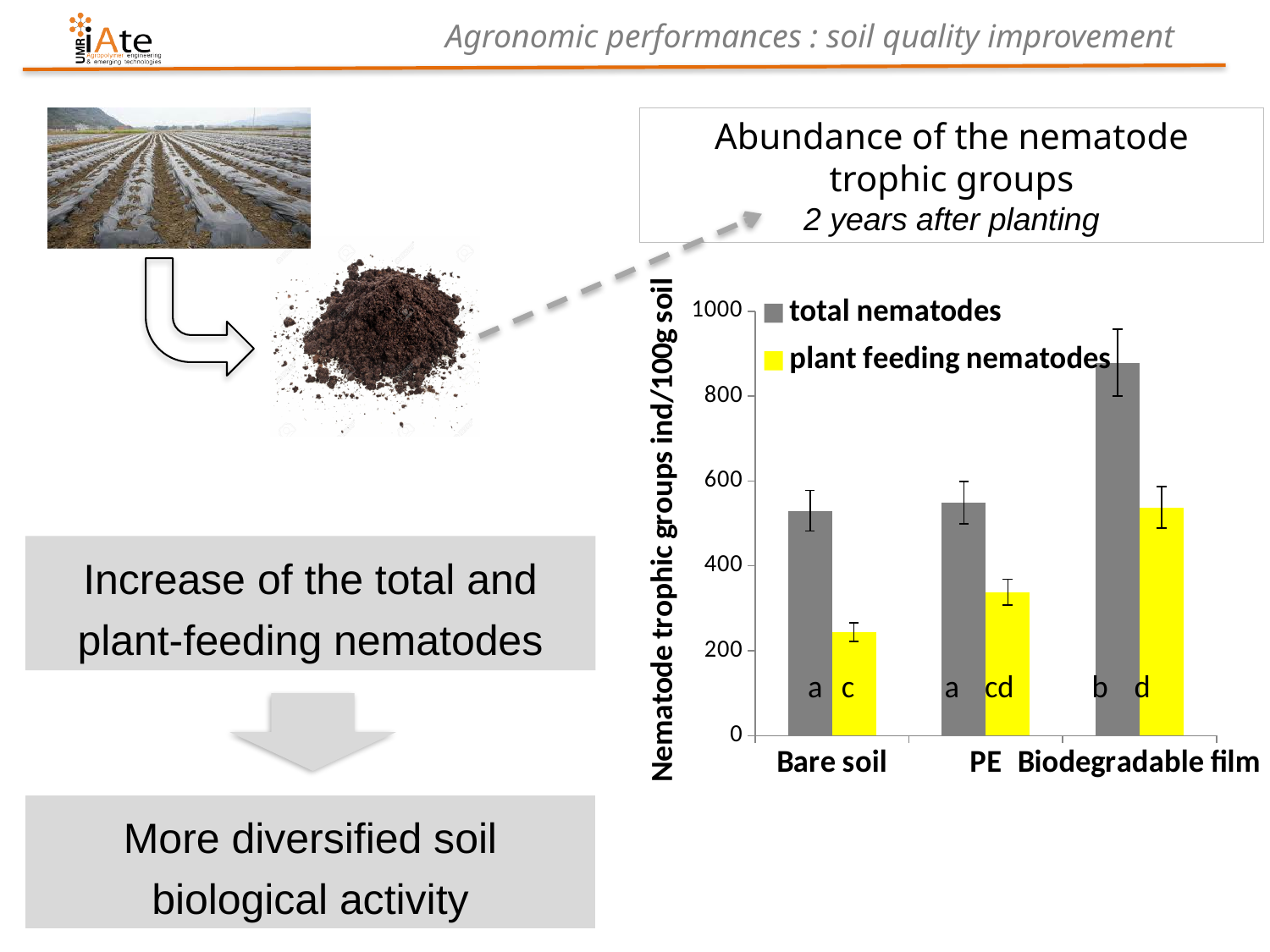
What kind of chart is shown on the slide? bar chart Which is larger: plant feeding nematodes for PE or plant feeding nematodes for Bare soil? PE Which category has the lowest value for plant feeding nematodes? Bare soil Which category has the highest value for total nematodes? Biodegradable film Is the value for plant feeding nematodes in Bare soil greater or less than 400? less How many categories are shown on the x axis of the chart? 3 Which colour represents plant feeding nematodes in the chart? yellow How many series does the chart legend list? 2 Which is larger: total nematodes for Biodegradable film or total nematodes for PE? Biodegradable film Is the value for total nematodes in Biodegradable film greater or less than 800? greater What is the title of the chart? Abundance of the nematode trophic groups Is the value for plant feeding nematodes in Biodegradable film greater or less than 400? greater